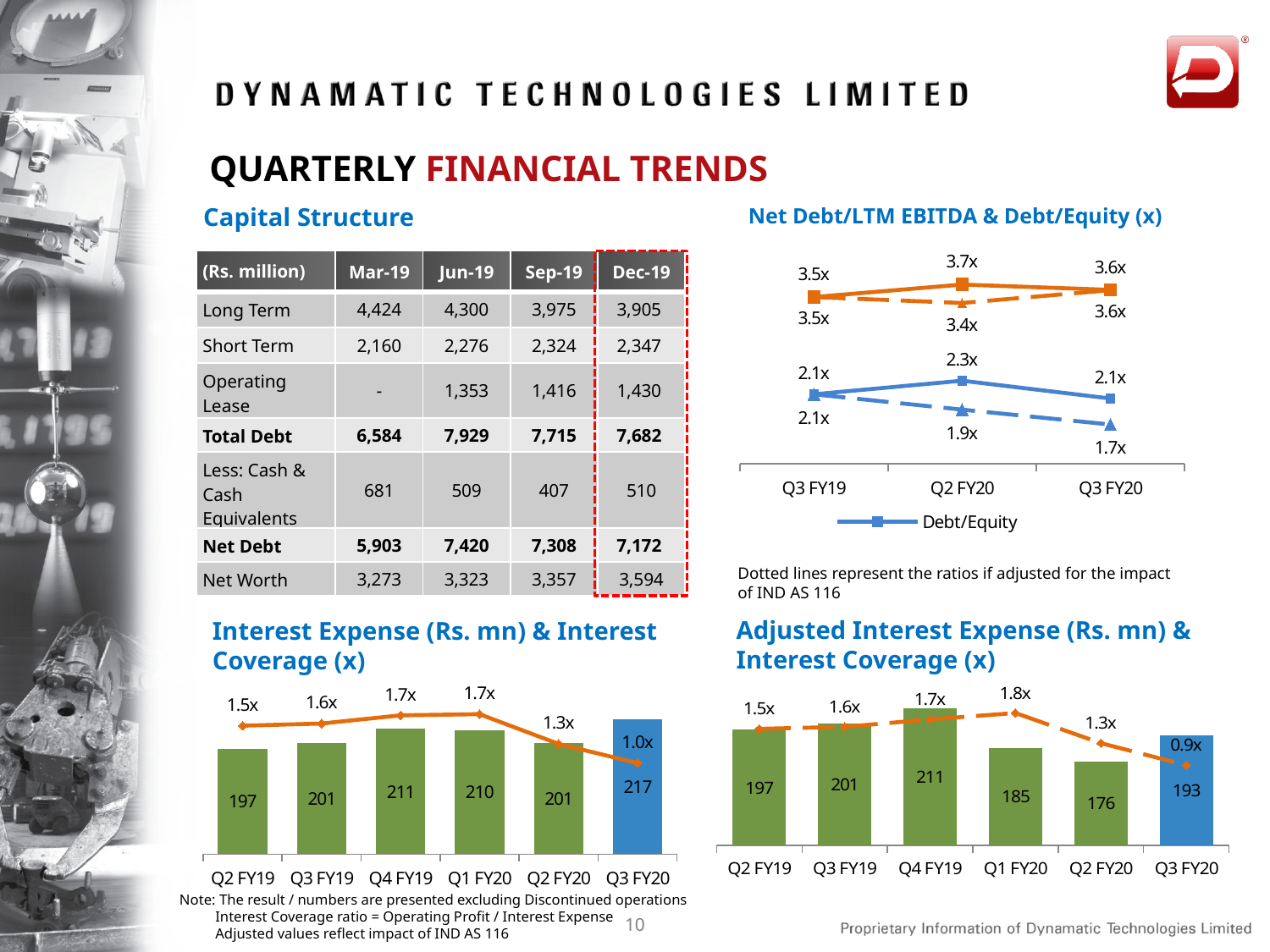
In the 'Interest Expense (Rs. mn) & Interest Coverage (x)' chart, which quarter has the highest interest expense? Q3 FY20 In the 'Net Debt/LTM EBITDA & Debt/Equity (x)' chart, which series is named in the legend? Debt/Equity In the 'Interest Expense (Rs. mn) & Interest Coverage (x)' chart, what is the interest coverage ratio for Q2 FY20? 1.3x In the 'Adjusted Interest Expense (Rs. mn) & Interest Coverage (x)' chart, what is the adjusted interest expense for Q2 FY20? 176 In the 'Net Debt/LTM EBITDA & Debt/Equity (x)' chart, what is the solid-line Debt/Equity value for Q2 FY20? 2.3x In the 'Adjusted Interest Expense (Rs. mn) & Interest Coverage (x)' chart, how many quarters are shown on the x axis? 6 In the 'Adjusted Interest Expense (Rs. mn) & Interest Coverage (x)' chart, what is the interest coverage ratio for Q3 FY20? 0.9x In the 'Interest Expense (Rs. mn) & Interest Coverage (x)' chart, what is the interest expense for Q3 FY20? 217 In the 'Adjusted Interest Expense (Rs. mn) & Interest Coverage (x)' chart, which quarter has the lowest adjusted interest expense? Q2 FY20 In the 'Net Debt/LTM EBITDA & Debt/Equity (x)' chart, what is the dotted-line Debt/Equity value for Q3 FY20? 1.7x What kind of chart is the 'Net Debt/LTM EBITDA & Debt/Equity (x)' chart? Line chart In the 'Interest Expense (Rs. mn) & Interest Coverage (x)' chart, what is the difference in interest expense between Q3 FY20 and Q2 FY20? 16